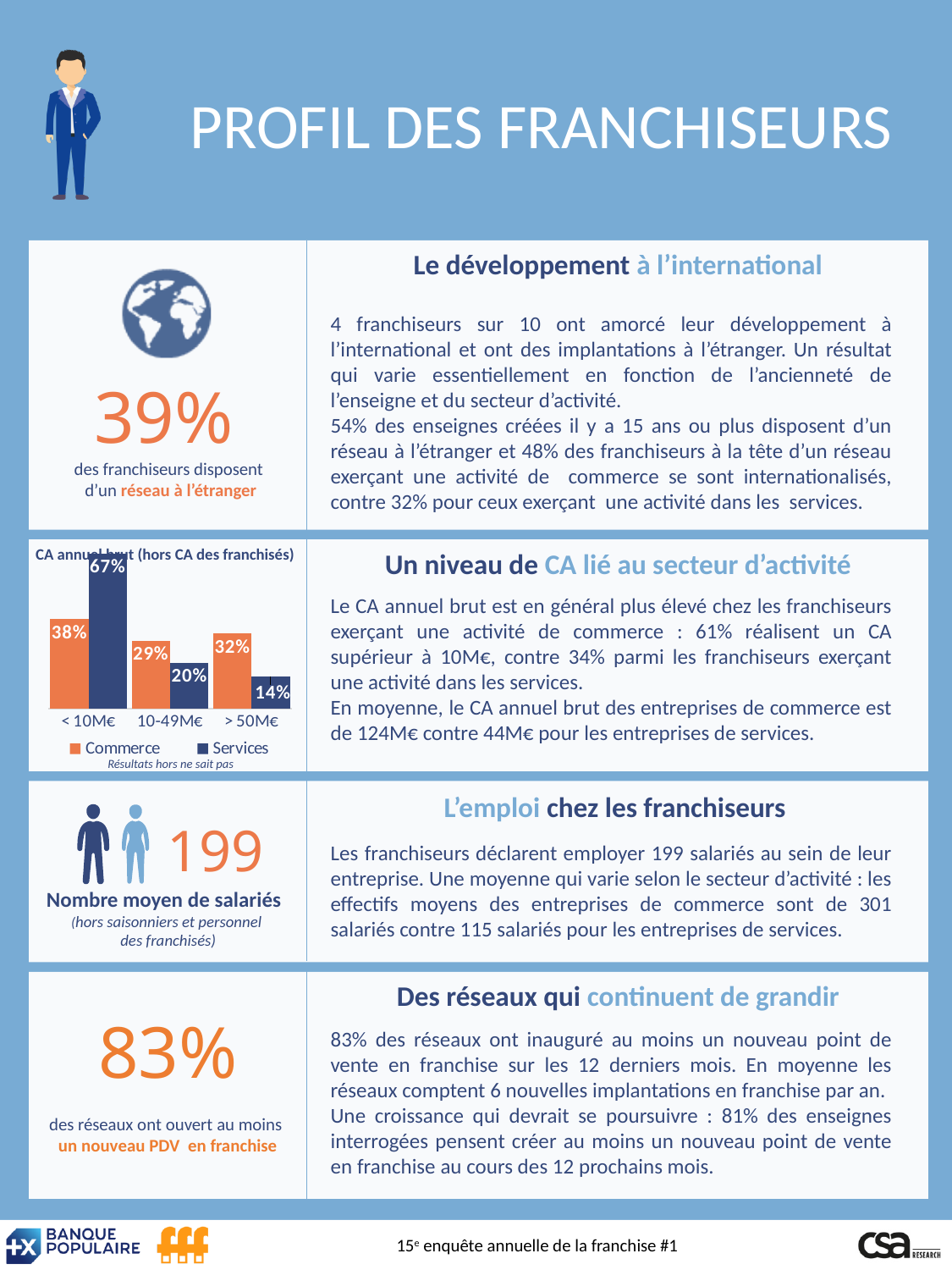
Which category has the highest value for the Services series? < 10M€ How many series does the chart's legend list? 2 Which category has the lowest value for the Commerce series? 10-49M€ What kind of chart is shown on the slide? bar chart In the > 50M€ category, which series has the larger value, Commerce or Services? Commerce How many categories are shown on the x axis of the chart? 3 What is the value for Services in the < 10M€ category? 67% What is the value for Commerce in the 10-49M€ category? 29% What is the value for Services in the > 50M€ category? 14% What is the title of the chart? CA annuel brut (hors CA des franchisés) What is the value for Commerce in the < 10M€ category? 38% What is the difference between the Services and Commerce values in the < 10M€ category? 29%